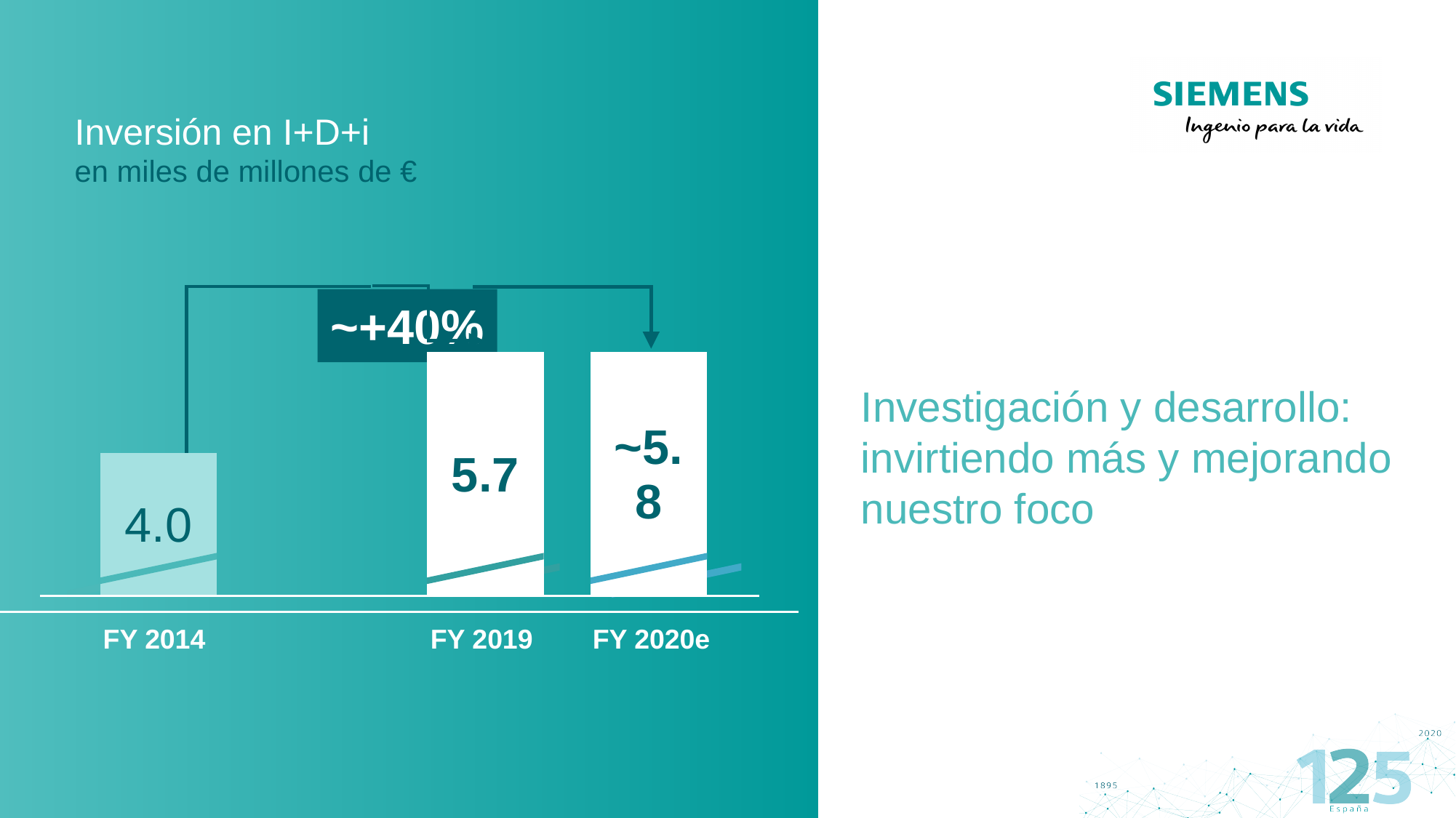
Which is larger, the value for FY 2019 or the value for FY 2014? FY 2019 What value is printed on the FY 2020e bar? ~5.8 How many bars are shown in the chart? 3 What is the difference between the FY 2019 value and the FY 2014 value? 1.7 Which year has the lowest value? FY 2014 What is the value for FY 2019? 5.7 Do the values rise or fall from FY 2014 to FY 2020e? Rise What is the value for FY 2014? 4.0 What is the title of the chart? Inversión en I+D+i What kind of chart is shown on the slide? Bar chart What percentage change is annotated between FY 2014 and the later years? ~+40%